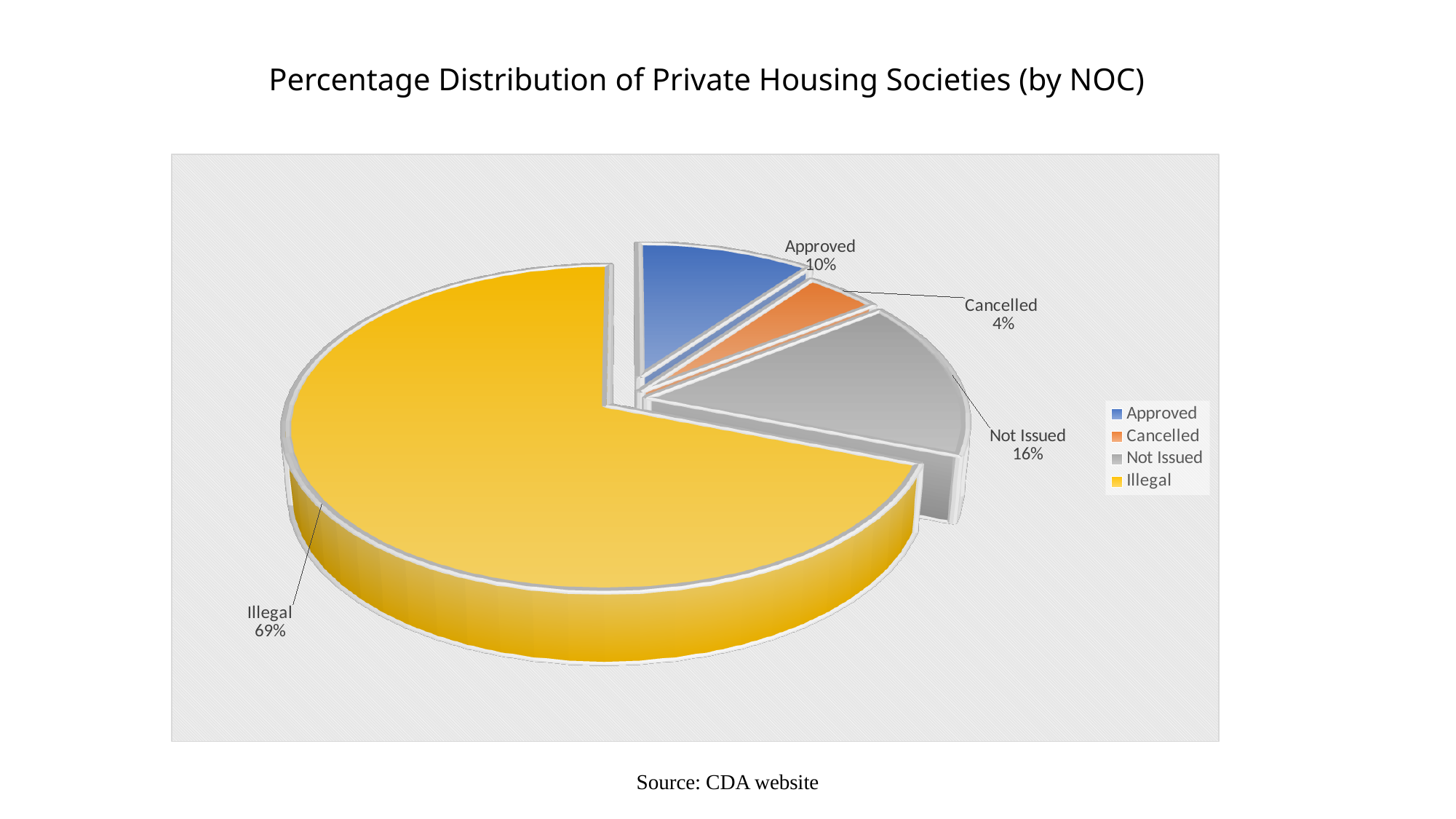
What percentage of private housing societies are Cancelled? 4% What is the title of the chart? Percentage Distribution of Private Housing Societies (by NOC) What percentage of private housing societies are Approved? 10% What percentage of private housing societies are Illegal? 69% What kind of chart is shown on the slide? Pie chart Which category has the smallest share of the pie? Cancelled Which is larger, the Approved slice or the Cancelled slice? Approved How many categories are shown in the pie chart? 4 What percentage of private housing societies have NOC Not Issued? 16% Which category has the largest share of the pie? Illegal What colour is the Illegal slice in the pie chart? Yellow What is the difference in percentage points between the Not Issued and Approved slices? 6